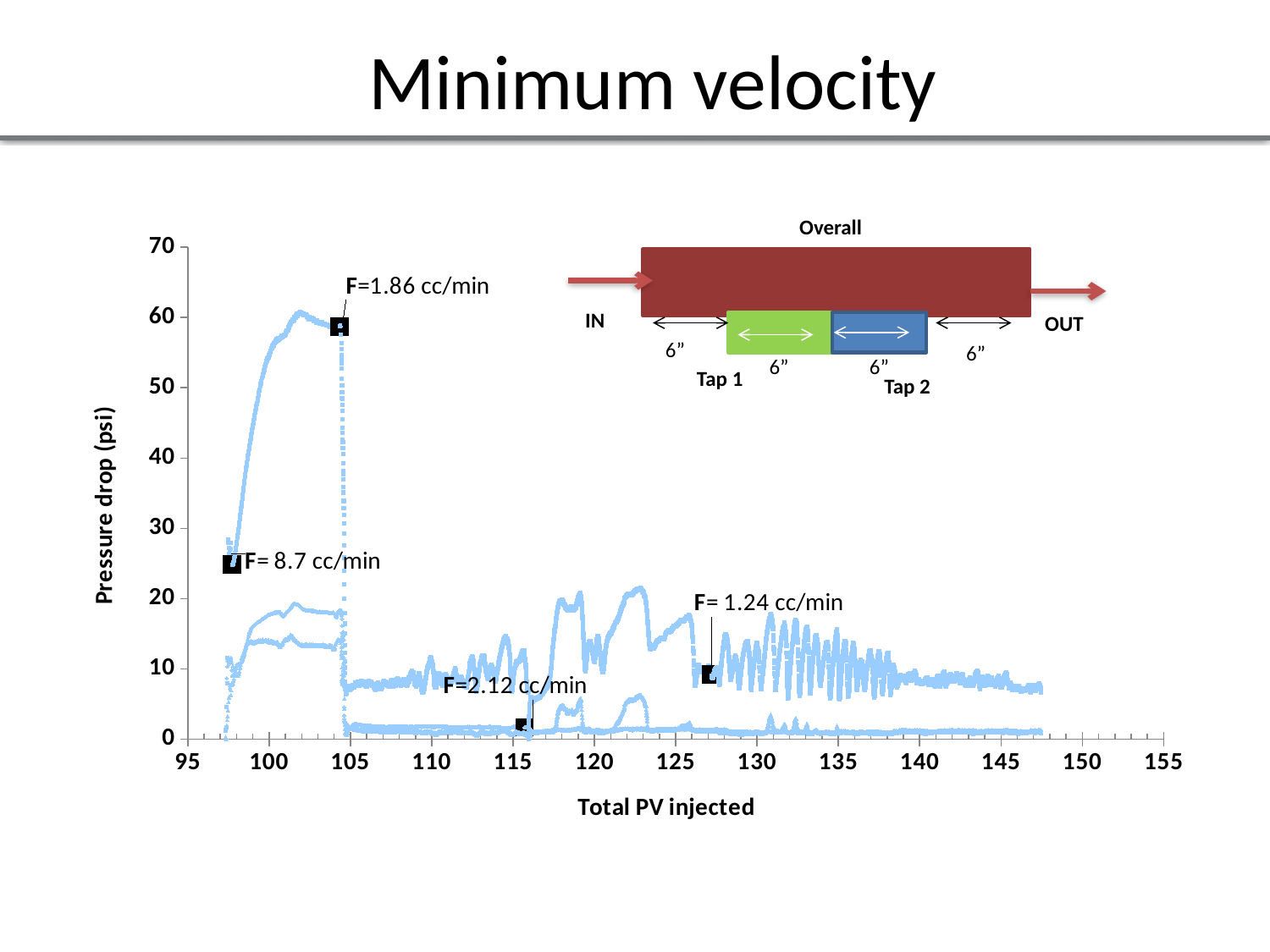
Does the top curve rise or fall between a total PV injected of 98 and 102? rise How many flow-rate (F) annotations are marked on the chart? 4 Is the pressure drop of the top curve at a total PV injected of 110 greater or less than 20 psi? less What flow rate F is annotated near a total PV injected of about 127? 1.24 cc/min What kind of chart is shown on the slide? line chart What flow rate F is annotated at the point near a total PV injected of about 104, where the pressure drop is near 60 psi? 1.86 cc/min Is the pressure drop of the top curve at a total PV injected of 145 greater or less than 20 psi? less What flow rate F is annotated at the start of the data, near a total PV injected of about 97? 8.7 cc/min What flow rate F is annotated near a total PV injected of about 116? 2.12 cc/min What is the label of the vertical axis of the chart? Pressure drop (psi) Is the peak pressure drop of the top curve near a total PV injected of 102 greater or less than 50 psi? greater What is the label of the horizontal axis of the chart? Total PV injected